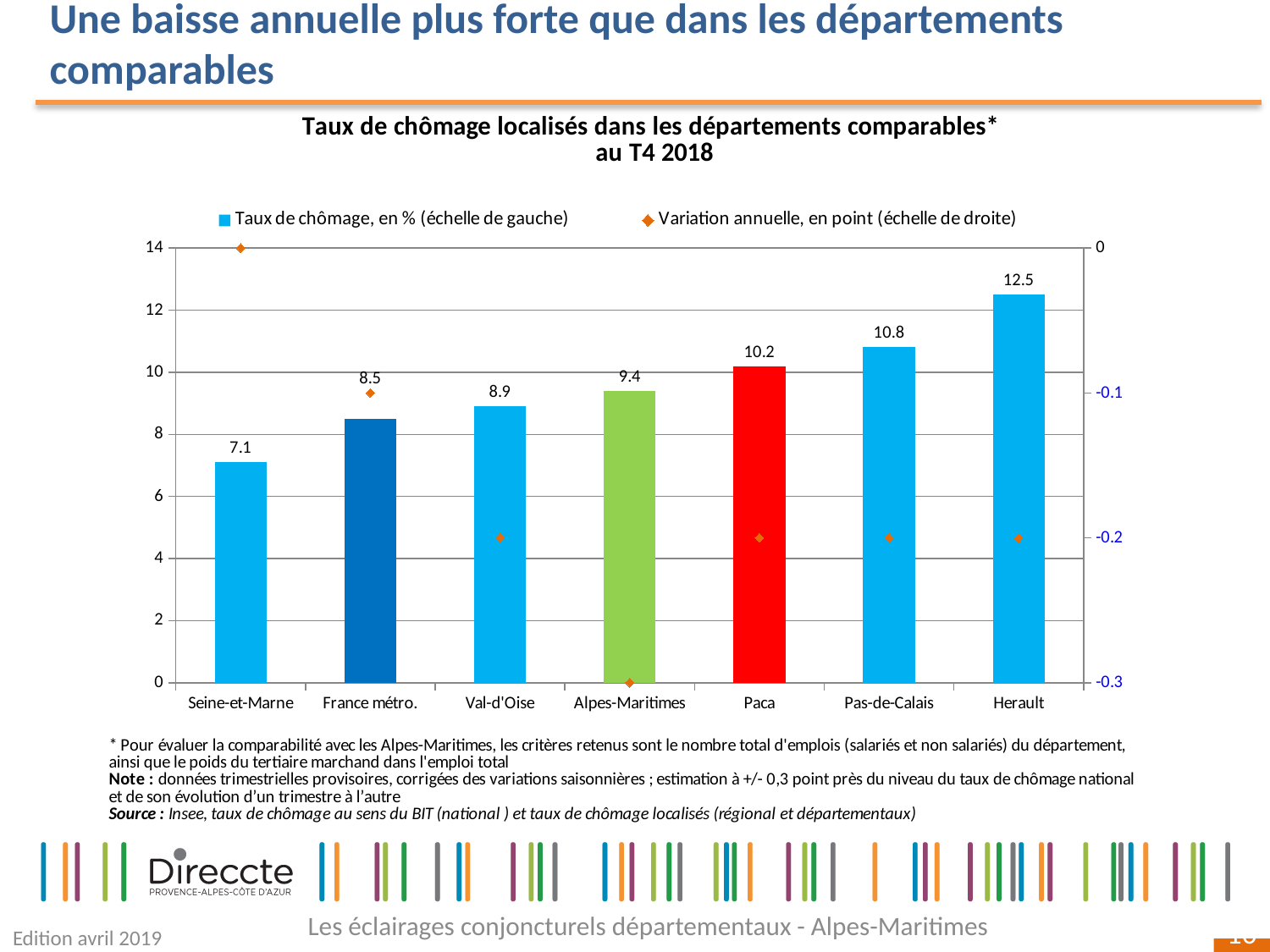
Which department has the highest unemployment rate on the chart? Herault Which department has the lowest unemployment rate on the chart? Seine-et-Marne How many departments or areas are shown on the x axis of the chart? 7 What is the unemployment rate (taux de chômage) shown for Alpes-Maritimes? 9.4 What is the unemployment rate shown for Seine-et-Marne? 7.1 What is the title of the chart? Taux de chômage localisés dans les départements comparables* au T4 2018 What is the difference between the unemployment rates of Herault and Alpes-Maritimes? 3.1 Which has a higher unemployment rate, Paca or Pas-de-Calais? Pas-de-Calais What is the unemployment rate shown for France métro.? 8.5 According to the right-hand axis, what is the annual variation (variation annuelle) in points for Alpes-Maritimes? -0.3 How many series does the chart legend list? 2 What kind of chart is used to show the unemployment rates? Bar chart